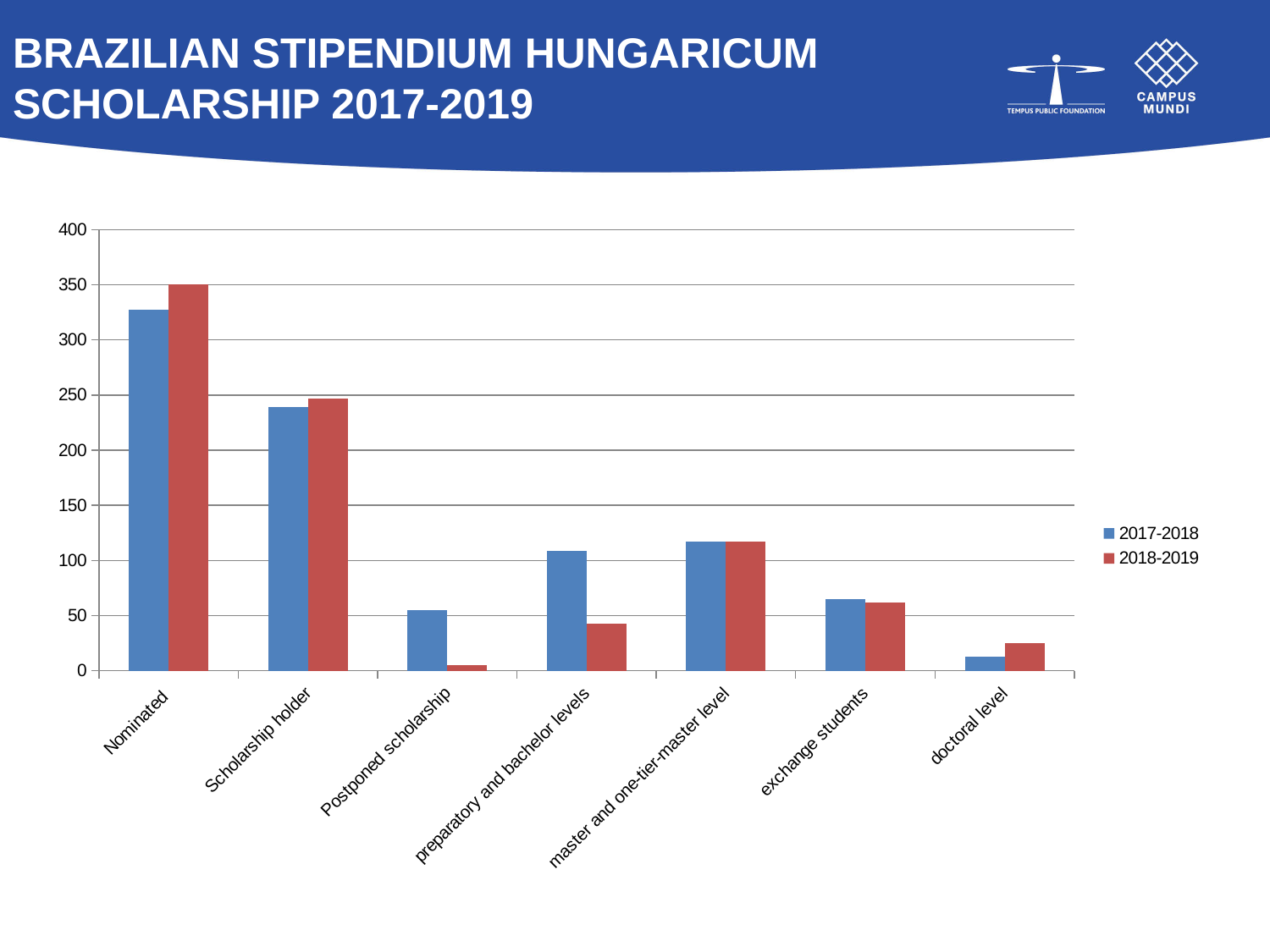
Which category has the highest value for the 2017-2018 series? Nominated Is the 2017-2018 value for Scholarship holder greater or less than 250? less What are the two series named in the legend? 2017-2018 and 2018-2019 What kind of chart is shown on the slide? bar chart How many series does the legend list? 2 Which category has the lowest value for the 2018-2019 series? Postponed scholarship How many categories are shown on the x axis? 7 For Postponed scholarship, which series has the larger value, 2017-2018 or 2018-2019? 2017-2018 Which category has the lowest value for the 2017-2018 series? doctoral level Is the 2017-2018 value for Nominated greater or less than 300? greater Is the 2018-2019 value for preparatory and bachelor levels greater or less than 50? less For doctoral level, which series has the larger value, 2017-2018 or 2018-2019? 2018-2019